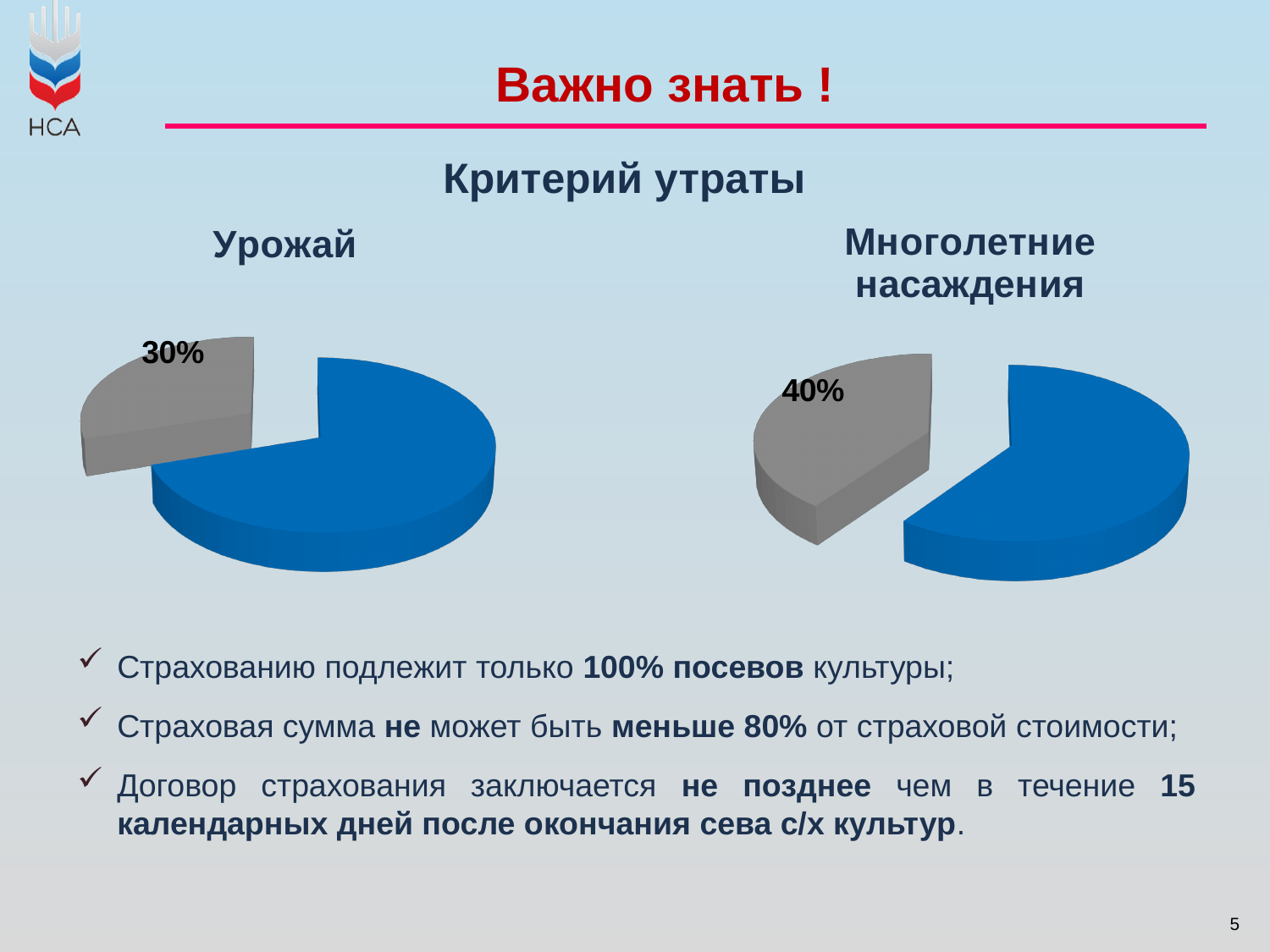
How many pie charts are on the slide? 2 Is the labelled grey slice in the "Урожай" pie chart greater or less than half of the pie? less How many slices does the "Урожай" pie chart have? 2 How many slices does the "Многолетние насаждения" pie chart have? 2 What kind of charts are shown on the slide? Pie charts Which pie chart has the larger labelled grey slice, "Урожай" or "Многолетние насаждения"? Многолетние насаждения What heading is shown above the two pie charts? Критерий утраты In the "Многолетние насаждения" pie chart, which slice is larger, the blue one or the grey one? Blue In the "Урожай" pie chart, which slice is larger, the blue one or the grey one? Blue In the "Урожай" pie chart, what value is printed on the grey slice? 30% In the "Многолетние насаждения" pie chart, what value is printed on the grey slice? 40% What is the difference between the labelled slice in the "Многолетние насаждения" chart and the labelled slice in the "Урожай" chart? 10%